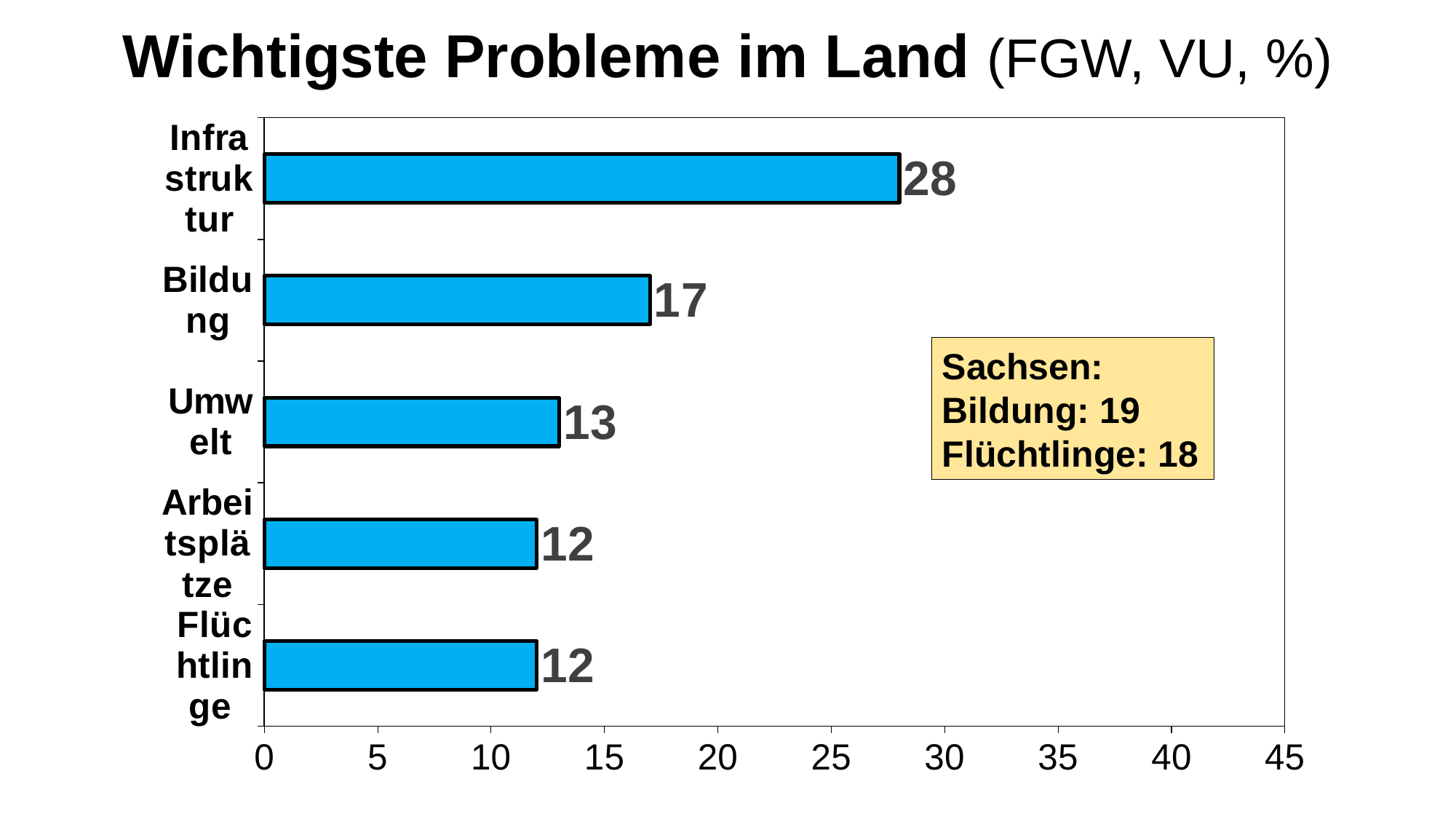
What is the value for Umwelt? 13 Which is larger, the value for Bildung or the value for Umwelt? Bildung How many categories are shown in the chart? 5 What is the value for Infrastruktur? 28 What is the value for Bildung? 17 Which category has the highest value? Infrastruktur What is the value for Arbeitsplätze? 12 What kind of chart is shown on the slide? Bar chart According to the text box, what is the value for Bildung in Sachsen? 19 What is the difference between the values for Infrastruktur and Bildung? 11 What is the difference between the values for Bildung and Umwelt? 4 Is the value for Infrastruktur greater or less than 25? greater